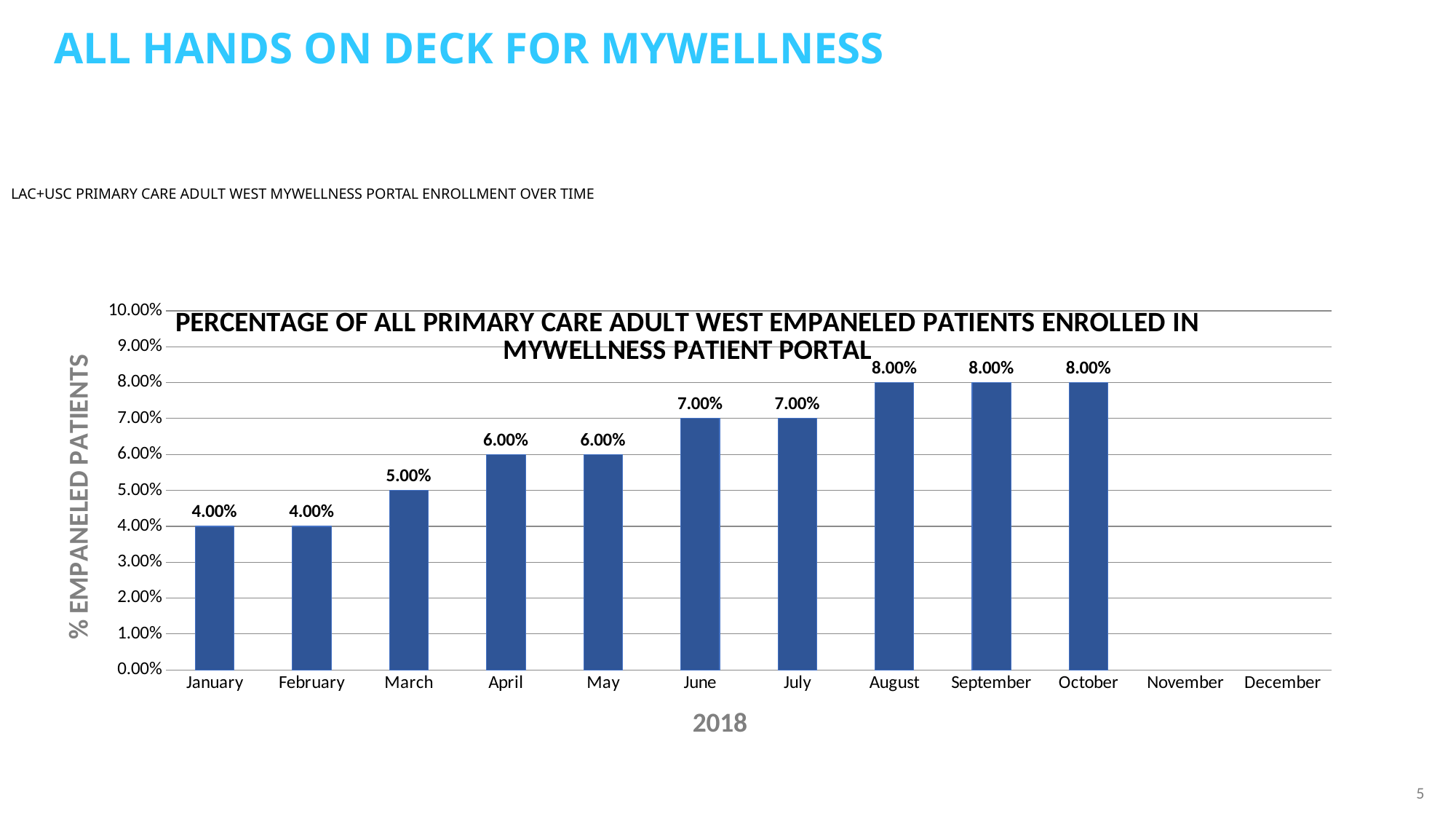
Do the values rise or fall from January to October? Rise What is the value for January? 4.00% What is the value for March? 5.00% How many months are labeled on the x axis? 12 What is the y-axis title of the chart? % EMPANELED PATIENTS Which month has the lowest value among those with bars? January and February What kind of chart is shown? Bar chart What is the difference between the values for August and January? 4.00% Which is larger, the value for April or the value for July? July What is the value for June? 7.00% How many months have a bar plotted? 10 What is the value for October? 8.00%